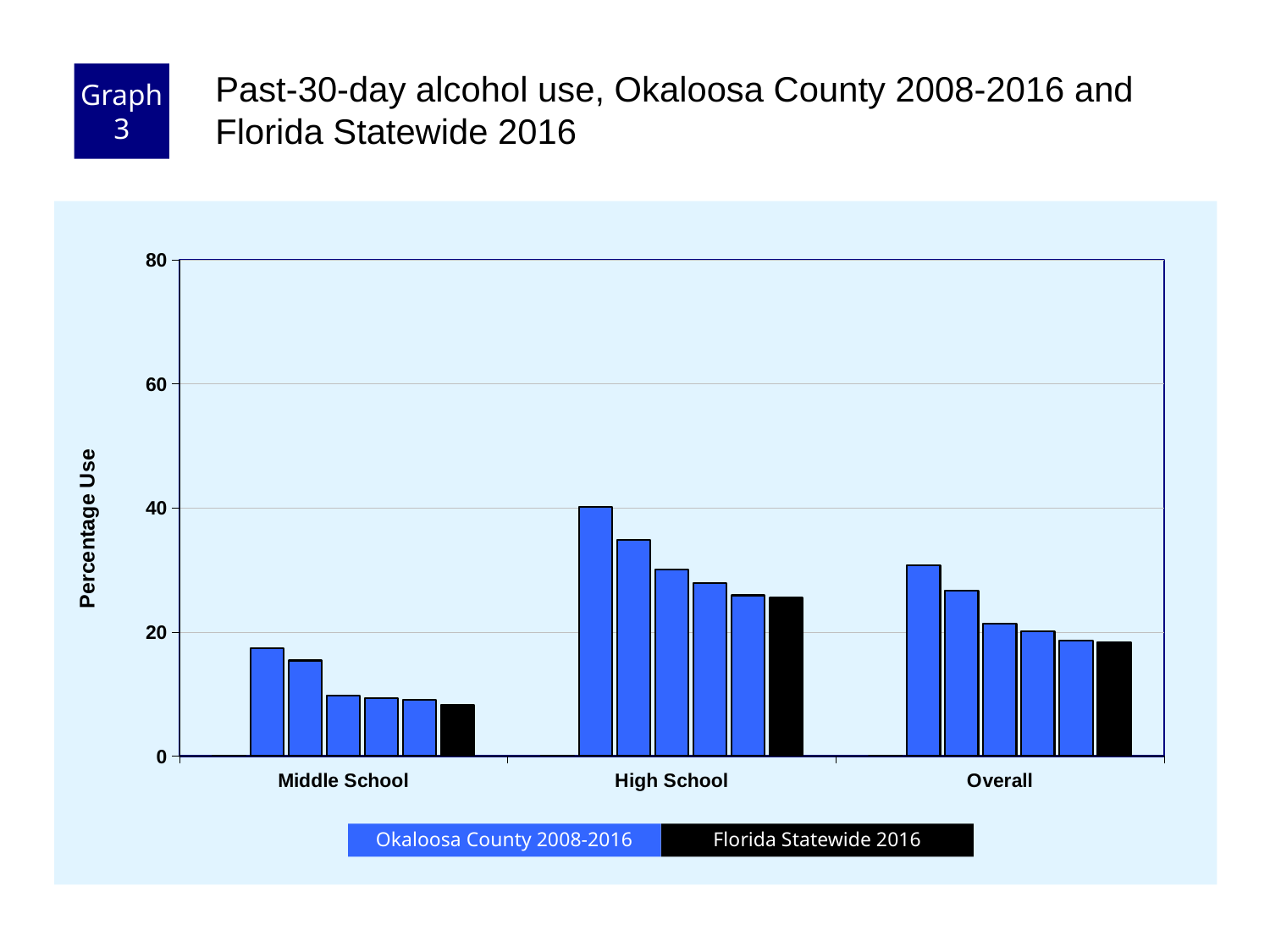
Is the Florida Statewide 2016 value for Middle School greater or less than 20? less Within the High School group, do the Okaloosa County bars rise or fall from 2008 to 2016? fall How many series does the legend list? 2 How many categories are shown along the x axis? 3 Which is larger, the Florida Statewide 2016 value for High School or for Overall? High School What is the label on the y axis? Percentage Use What kind of chart is shown on the slide? bar chart Is the tallest Okaloosa County bar for Overall greater or less than 20? greater Which category has the highest bars? High School Is the Florida Statewide 2016 value for High School greater or less than 20? greater Which category has the lowest bars? Middle School